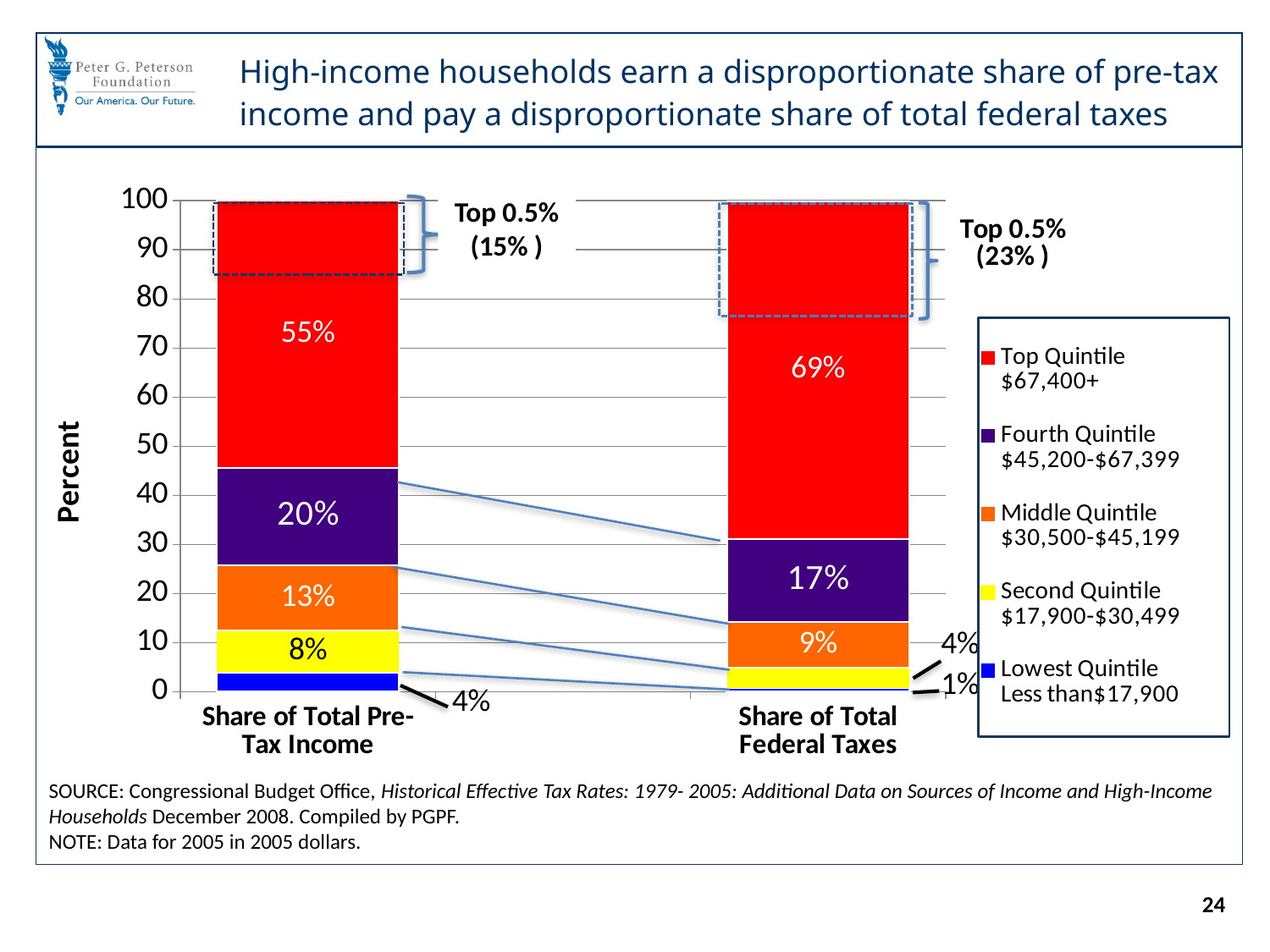
What is the Middle Quintile's share of total pre-tax income? 13% How many bars (categories) are plotted on the x axis? 2 By how many percentage points does the Top Quintile's share of total federal taxes exceed its share of total pre-tax income? 14 What income range does the legend give for the Middle Quintile? $30,500-$45,199 What kind of chart is shown on the slide? Stacked bar chart Which quintile has the smallest share of total pre-tax income? Lowest Quintile What is the Lowest Quintile's share of total federal taxes? 1% What is the Top Quintile's share of total pre-tax income? 55% How many series does the legend list? 5 Which is larger: the Fourth Quintile's share of total pre-tax income or its share of total federal taxes? Share of Total Pre-Tax Income According to the annotation, what share of total federal taxes is paid by the top 0.5%? 23% What is the Top Quintile's share of total federal taxes? 69%